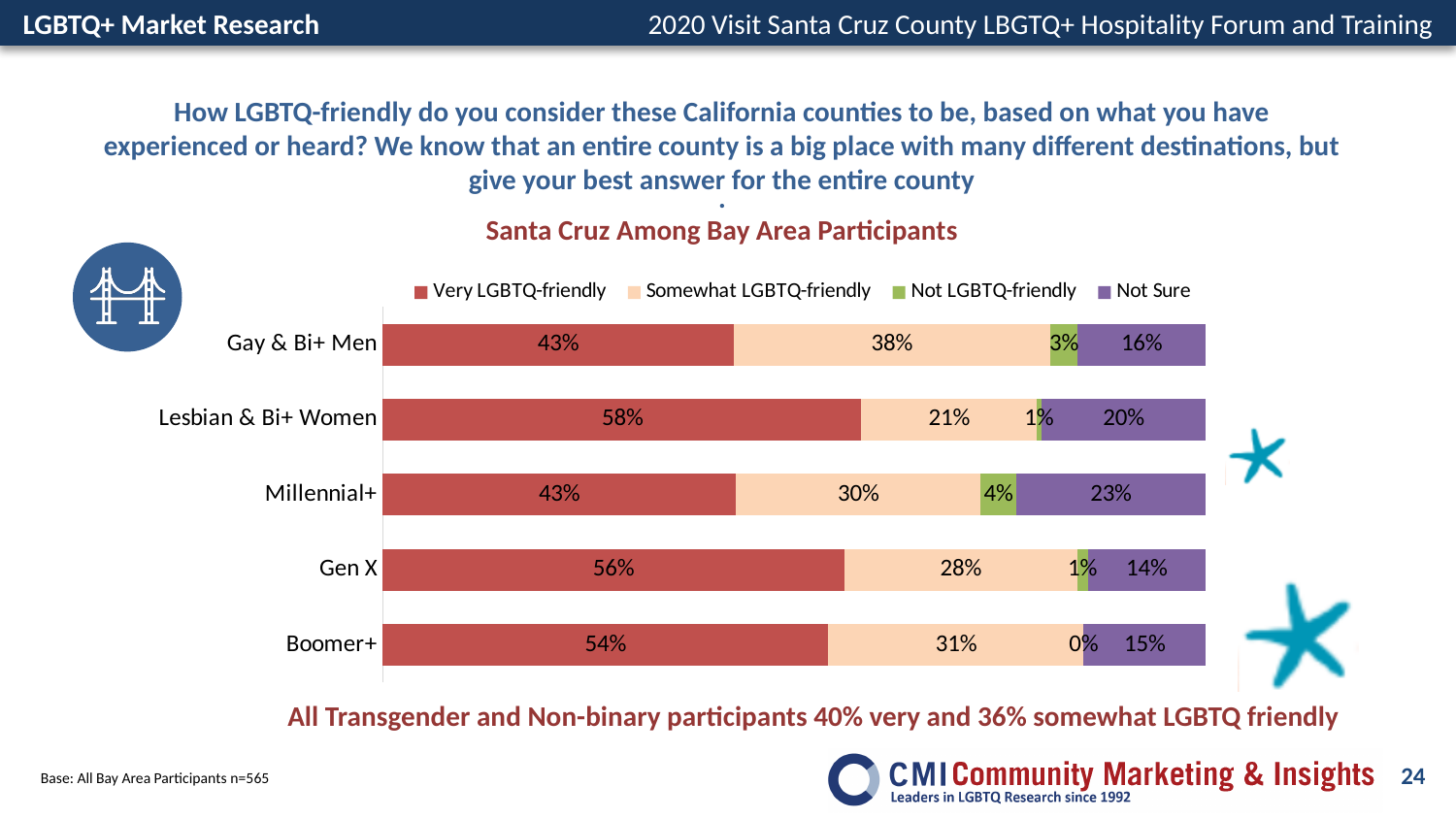
What is the Not LGBTQ-friendly value for Gay & Bi+ Men? 3% Which is larger: the Somewhat LGBTQ-friendly value for Gay & Bi+ Men or for Lesbian & Bi+ Women? Gay & Bi+ Men Which group has the lowest Not Sure percentage? Gen X How many groups are shown on the chart? 5 How many series does the legend list? 4 What is the difference between the Very LGBTQ-friendly values for Gen X and Millennial+? 13% What kind of chart is shown on the slide? Stacked bar chart What is the Somewhat LGBTQ-friendly value for Boomer+? 31% Which group has the highest Very LGBTQ-friendly percentage? Lesbian & Bi+ Women What is the title of the chart? Santa Cruz Among Bay Area Participants What is the Not Sure value for Millennial+? 23% What percentage of Lesbian & Bi+ Women rated Santa Cruz as Very LGBTQ-friendly? 58%